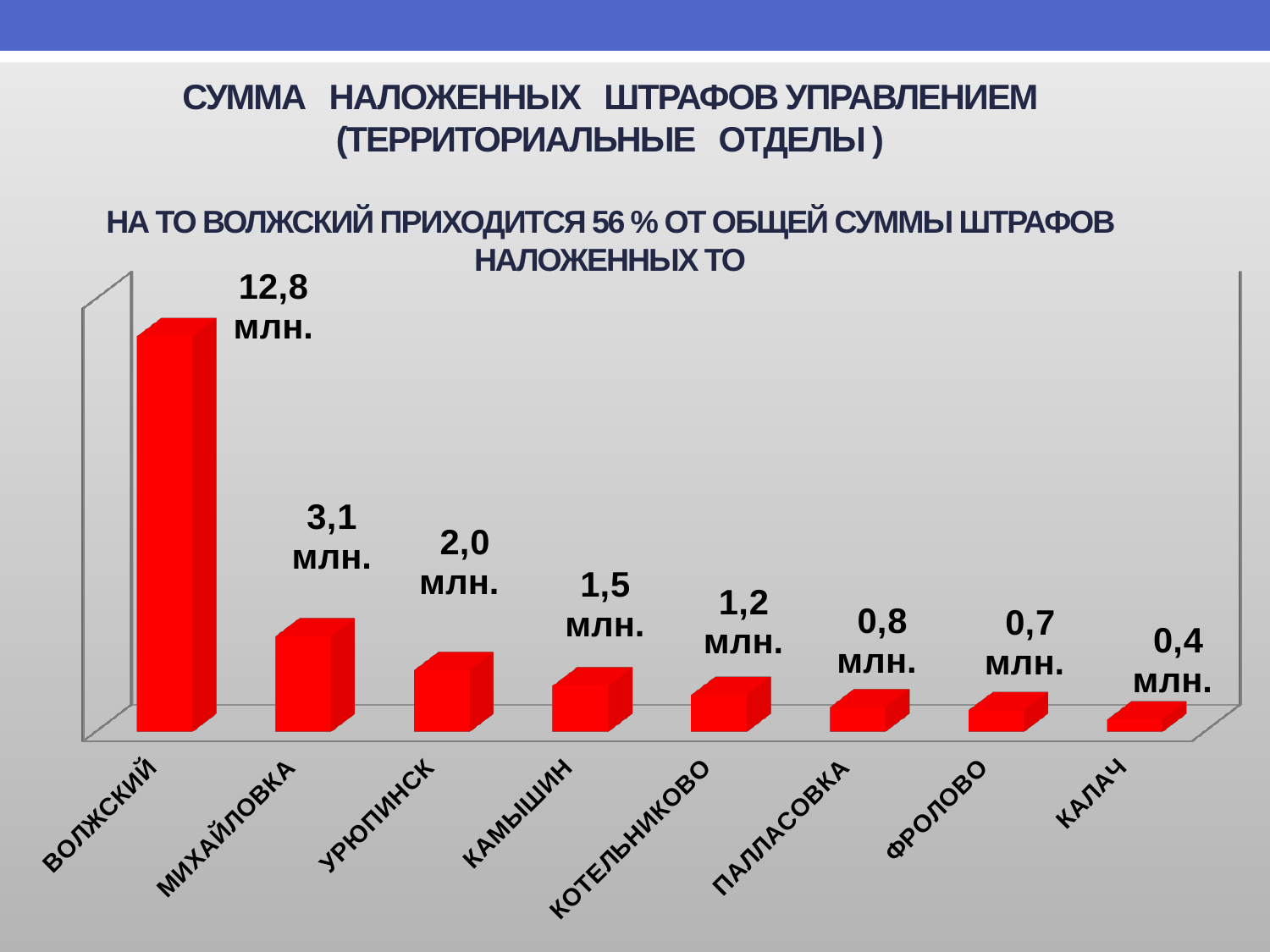
Which is larger, the value for ПАЛЛАСОВКА or the value for ФРОЛОВО? ПАЛЛАСОВКА How many categories are shown in the chart? 8 Do the values rise or fall from left to right along the x axis? Fall What is the difference between the values for УРЮПИНСК and КАМЫШИН? 0,5 млн. What is the difference between the values for ВОЛЖСКИЙ and МИХАЙЛОВКА? 9,7 млн. What is the value for КОТЕЛЬНИКОВО? 1,2 млн. Which category has the highest value? ВОЛЖСКИЙ Which category has the lowest value? КАЛАЧ What is the value for КАЛАЧ? 0,4 млн. What is the value for ВОЛЖСКИЙ? 12,8 млн. What kind of chart is shown on the slide? Bar chart What is the value for МИХАЙЛОВКА? 3,1 млн.